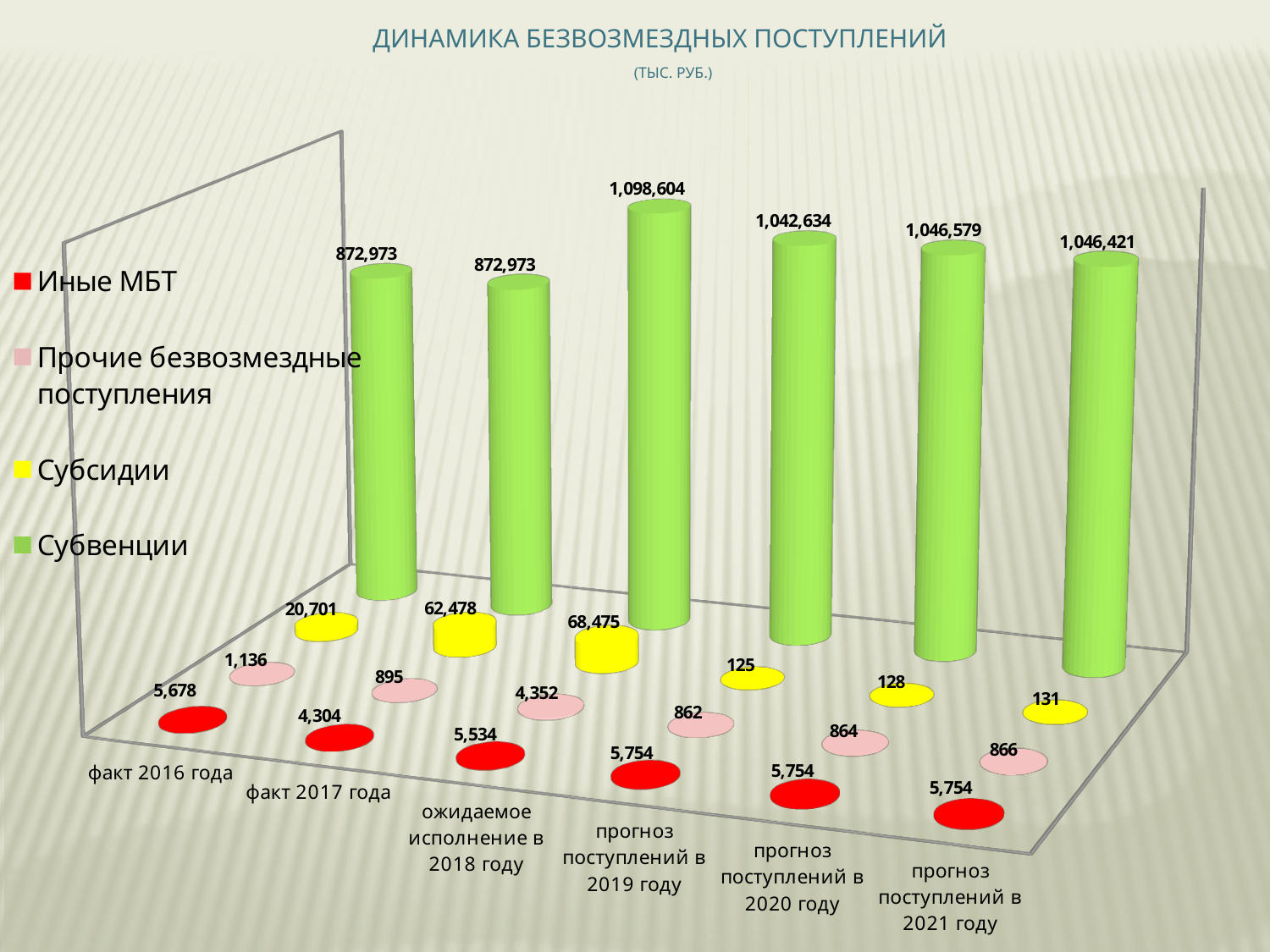
How many series does the legend list? 4 How many categories are shown on the x axis? 6 In which category is the Субвенции value highest? ожидаемое исполнение в 2018 году What colour represents Субвенции in the chart? green What is the value of Субсидии for факт 2017 года? 62,478 What is the difference between the Субвенции values for ожидаемое исполнение в 2018 году and факт 2017 года? 225,631 What kind of chart is shown on the slide? bar chart What is the value of Иные МБТ for факт 2016 года? 5,678 What is the value of Прочие безвозмездные поступления for прогноз поступлений в 2021 году? 866 What is the value of Субвенции for ожидаемое исполнение в 2018 году? 1,098,604 In which category is the Субсидии value lowest? прогноз поступлений в 2019 году Which is larger: Субсидии for факт 2016 года or Субсидии for ожидаемое исполнение в 2018 году? ожидаемое исполнение в 2018 году